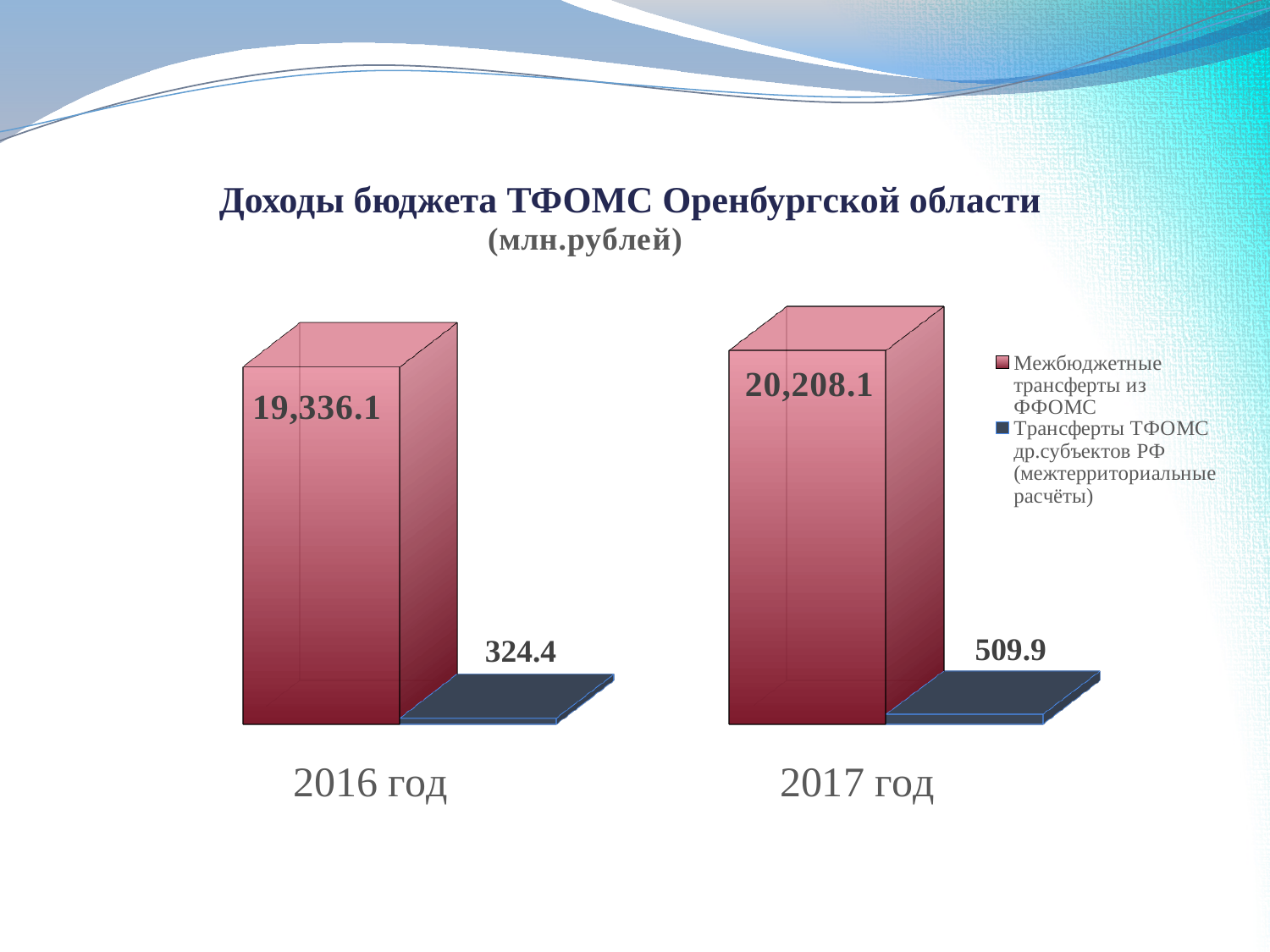
By how much did Межбюджетные трансферты из ФФОМС increase from 2016 год to 2017 год? 872.0 What type of chart is shown on the slide? Bar chart What is the value of Трансферты ТФОМС др.субъектов РФ (межтерриториальные расчёты) for 2017 год? 509.9 What is the value of Трансферты ТФОМС др.субъектов РФ (межтерриториальные расчёты) for 2016 год? 324.4 Which is larger: Трансферты ТФОМС др.субъектов РФ in 2016 год or in 2017 год? 2017 год In which year is the value of Межбюджетные трансферты из ФФОМС higher? 2017 год How many years (categories) are shown on the chart? 2 What is the value of Межбюджетные трансферты из ФФОМС for 2017 год? 20,208.1 How many series does the legend list? 2 What is the difference between the Трансферты ТФОМС др.субъектов РФ values for 2017 год and 2016 год? 185.5 What is the value of Межбюджетные трансферты из ФФОМС for 2016 год? 19,336.1 In which year is the value of Трансферты ТФОМС др.субъектов РФ (межтерриториальные расчёты) lower? 2016 год